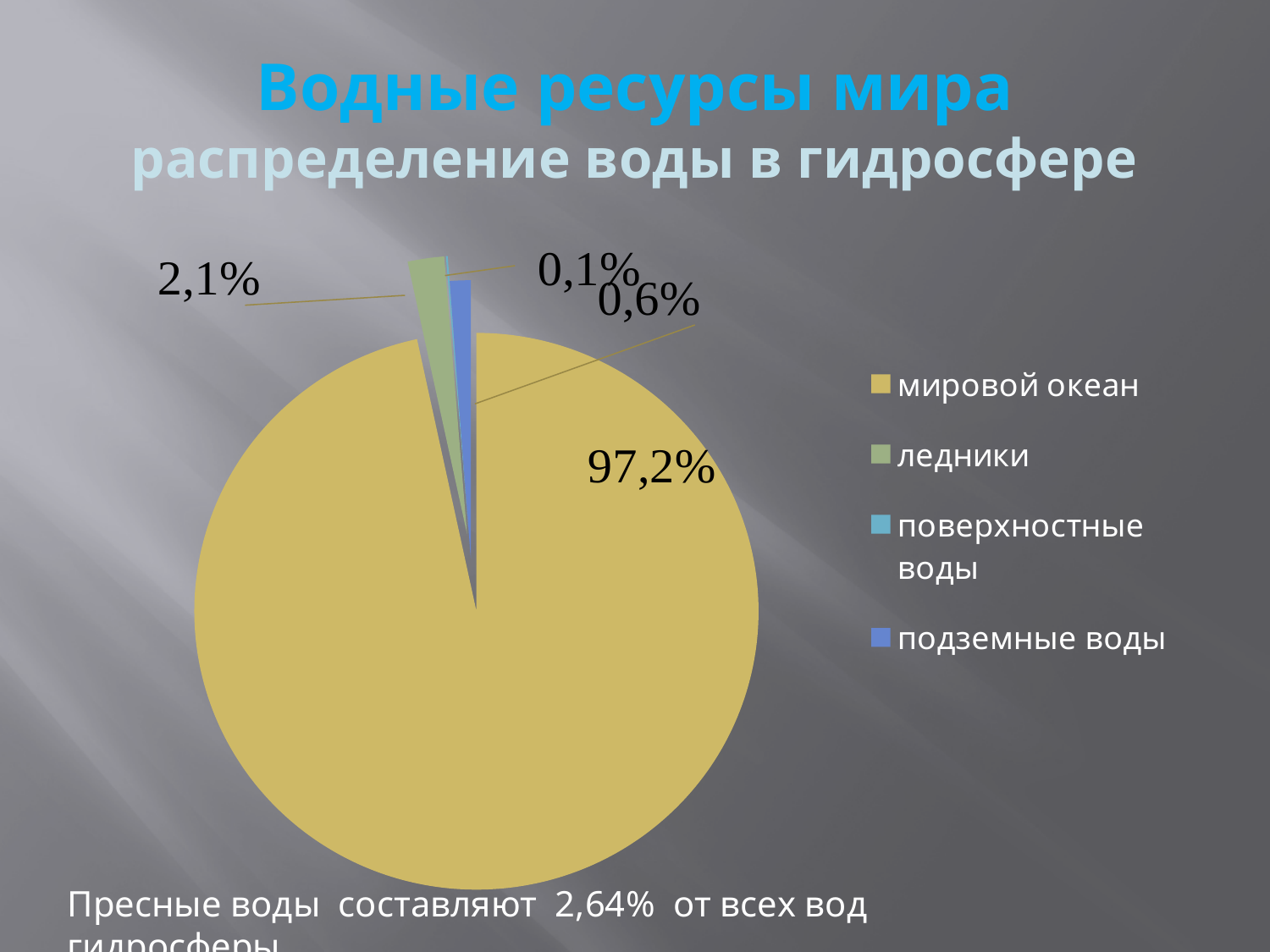
What type of chart is shown on the slide? pie chart What share of the pie does ледники have? 2,1% What colour is the slice for мировой океан? yellow Which is larger, the share for ледники or the share for подземные воды? ледники How many categories does the pie chart show? 4 What is the subtitle of the chart slide below 'Водные ресурсы мира'? распределение воды в гидросфере Which category has the smallest slice of the pie? поверхностные воды Which category has the largest slice of the pie? мировой океан How many entries does the legend list? 4 What is the difference between the share for мировой океан and the share for ледники? 95,1% What share of the pie does подземные воды have? 0,6% What share of the pie does мировой океан have? 97,2%